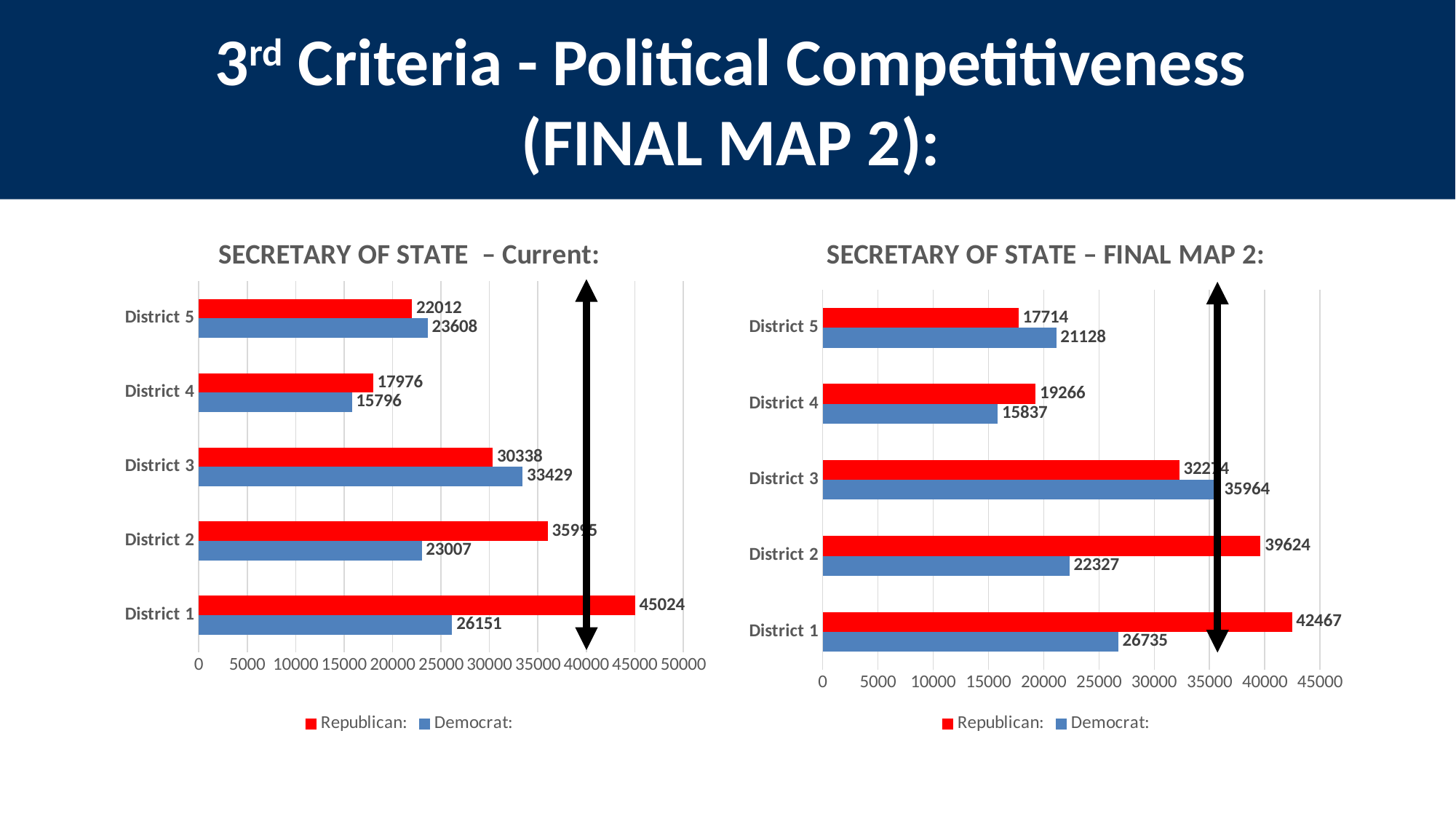
How many series does the legend of the SECRETARY OF STATE – FINAL MAP 2 chart list? 2 What type of chart is the SECRETARY OF STATE – Current chart? Bar chart In the SECRETARY OF STATE – FINAL MAP 2 chart, is the Republican or Democrat value larger for District 4? Republican In the SECRETARY OF STATE – Current chart, what is the Democrat value for District 3? 33429 In the SECRETARY OF STATE – Current chart, what is the Republican value for District 1? 45024 In the SECRETARY OF STATE – FINAL MAP 2 chart, which district has the lowest Democrat value? District 4 How many districts are shown in the SECRETARY OF STATE – Current chart? 5 In the SECRETARY OF STATE – FINAL MAP 2 chart, what is the difference between the Democrat and Republican values for District 5? 3414 In the SECRETARY OF STATE – FINAL MAP 2 chart, what is the Democrat value for District 5? 21128 In the SECRETARY OF STATE – Current chart, which district has the highest Republican value? District 1 In the SECRETARY OF STATE – FINAL MAP 2 chart, what is the Republican value for District 2? 39624 In the SECRETARY OF STATE – Current chart, what is the difference between the Republican and Democrat values for District 1? 18873